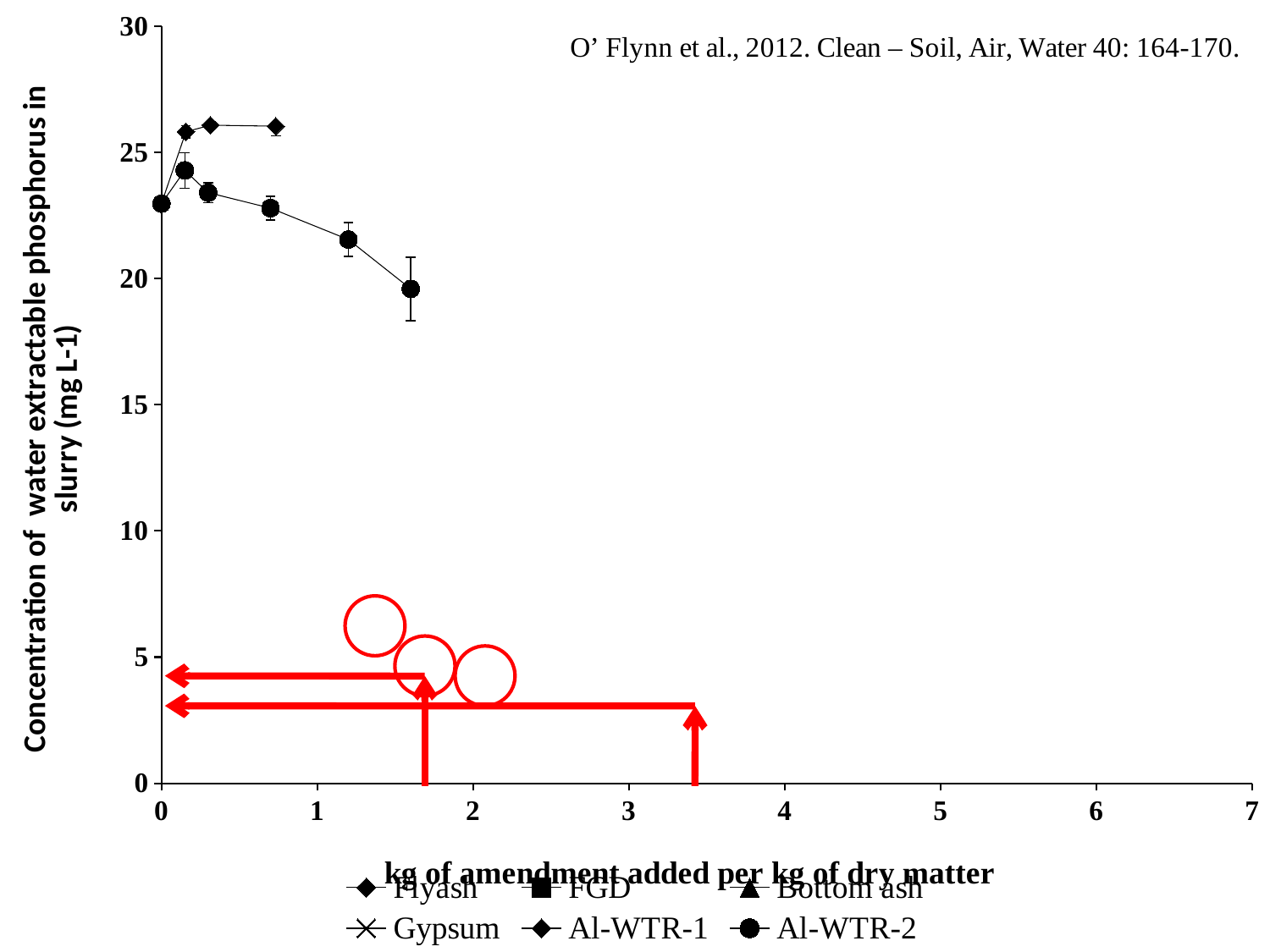
Is the value for Al-WTR-2 at about 1.2 kg of amendment greater or less than 20? greater Which series are listed in the legend? Flyash, FGD, Bottom ash, Gypsum, Al-WTR-1, Al-WTR-2 Which plotted series reaches the highest concentration on the chart? Al-WTR-1 At about 0.7 kg of amendment, which series has the larger value, Al-WTR-1 or Al-WTR-2? Al-WTR-1 How many data points are plotted for the Al-WTR-2 series? 6 Is the value for Al-WTR-2 at 0 kg of amendment greater or less than 25? less What kind of chart is shown on the slide? Line chart Is the value for Al-WTR-2 at about 1.6 kg of amendment greater or less than 20? less Does the Al-WTR-2 series rise or fall as the amount of amendment increases beyond about 0.15 kg? fall What is the title of the y axis? Concentration of water extractable phosphorus in slurry (mg L-1) How many series does the legend list? 6